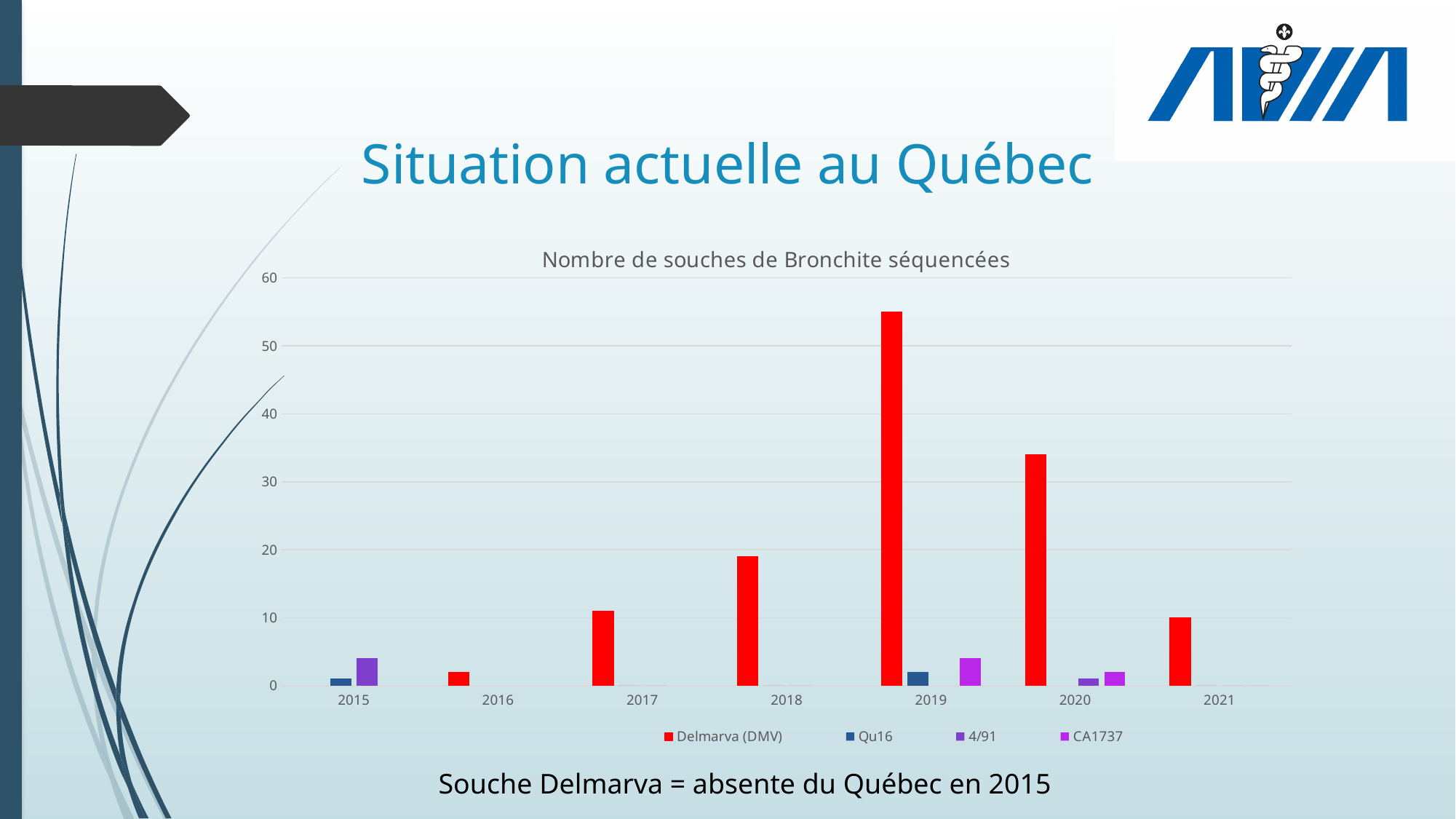
What kind of chart is shown on the slide? bar chart What is the title of the chart? Nombre de souches de Bronchite séquencées Which year has the larger Delmarva (DMV) value, 2017 or 2018? 2018 Which year has the larger Delmarva (DMV) value, 2019 or 2020? 2019 Is the Delmarva (DMV) value for 2016 greater or less than 10? less How many series does the legend list? 4 How many years are shown on the x axis? 7 Do the Delmarva (DMV) values rise or fall from 2016 to 2019? rise Is the Delmarva (DMV) value for 2020 greater or less than 30? greater Is the Delmarva (DMV) value for 2019 greater or less than 50? greater In which year is the Delmarva (DMV) value highest? 2019